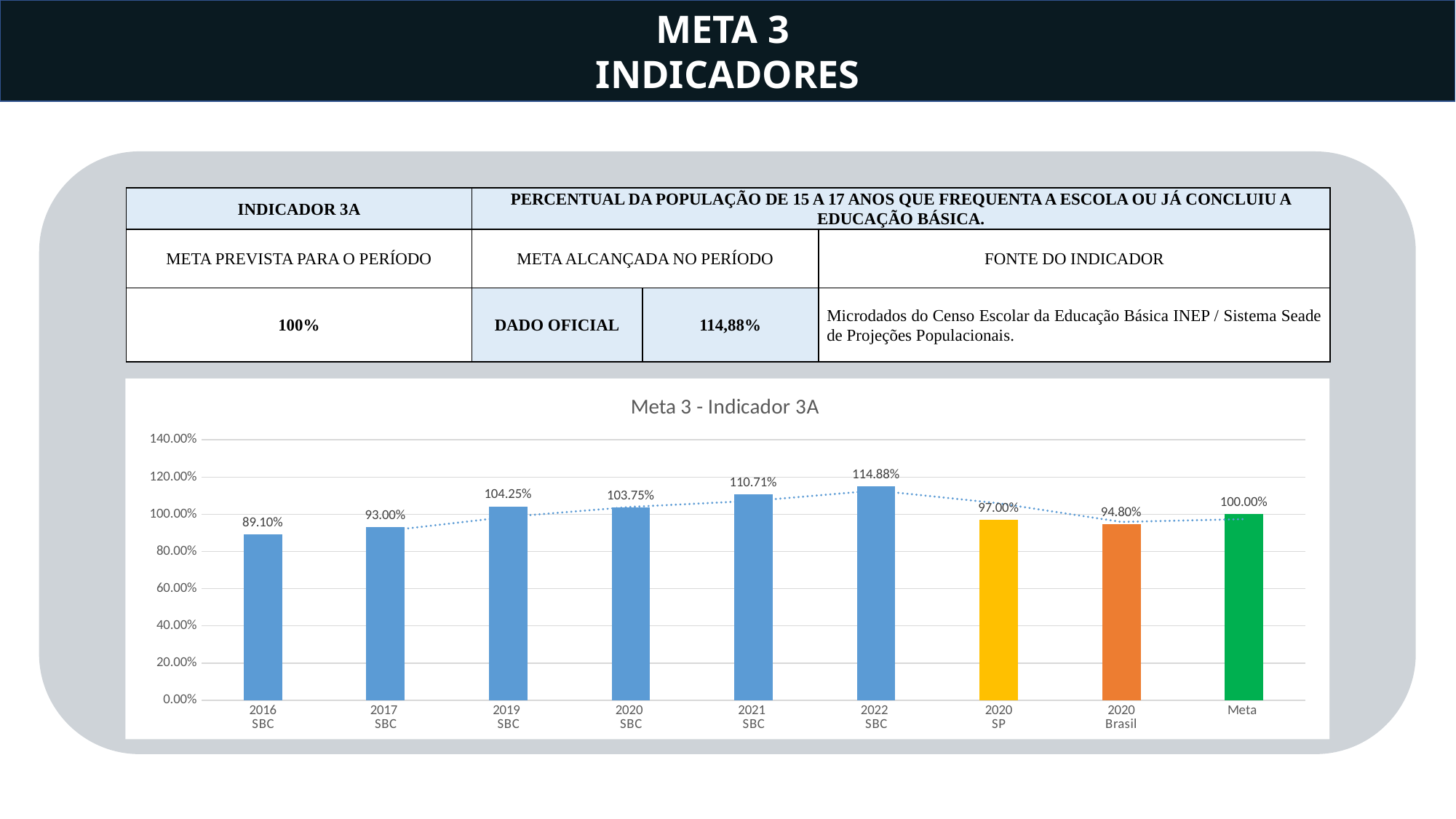
Which is larger, the value for 2020 SP or the value for 2020 Brasil? 2020 SP Which category has the lowest value? 2016 SBC How many bars are shown in the chart? 9 Which category has the highest value? 2022 SBC What is the value for 2016 SBC? 89.10% What is the value for 2020 SP? 97.00% What kind of chart is this? Bar chart What is the value for 2020 Brasil? 94.80% What is the value for 2022 SBC? 114.88% What is the title of the chart? Meta 3 - Indicador 3A What is the difference between the 2022 SBC value and the Meta value? 14.88% Is the value for 2021 SBC greater or less than 100.00%? greater